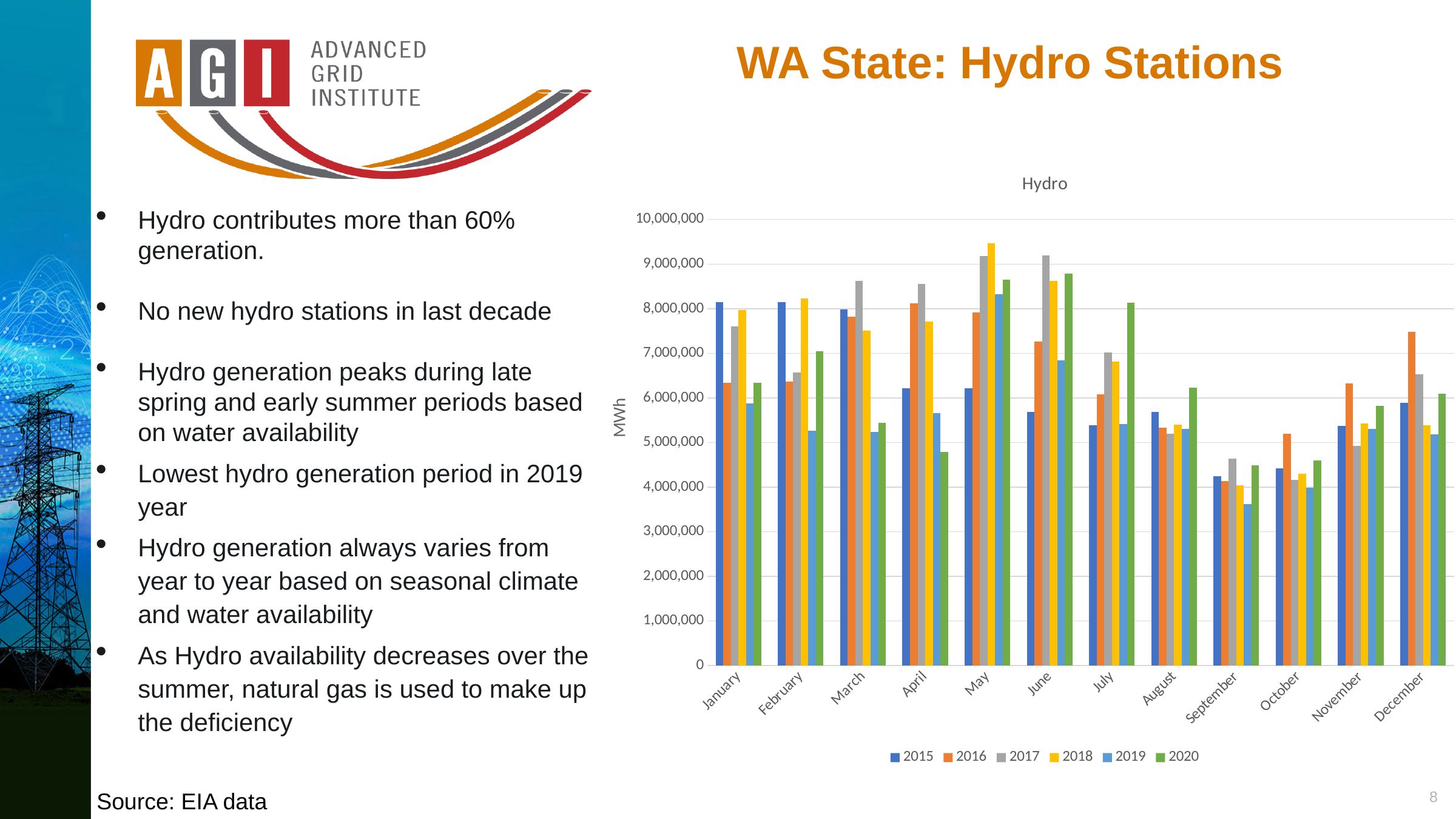
Is the value for 2018 in May greater or less than 9,000,000? greater What kind of chart is shown on the slide? bar chart Is the value for 2016 in December greater or less than 7,000,000? greater Is the value for 2019 in September greater or less than 4,000,000? less In June, which is larger: the value for 2017 or the value for 2016? 2017 Which year has the lowest hydro generation in April? 2020 Which year has the highest hydro generation in May? 2018 In January, which is larger: the value for 2015 or the value for 2019? 2015 Which year has the highest hydro generation in July? 2020 How many months are shown on the x axis of the Hydro chart? 12 What unit is shown on the y axis of the Hydro chart? MWh How many series does the legend of the Hydro chart list? 6